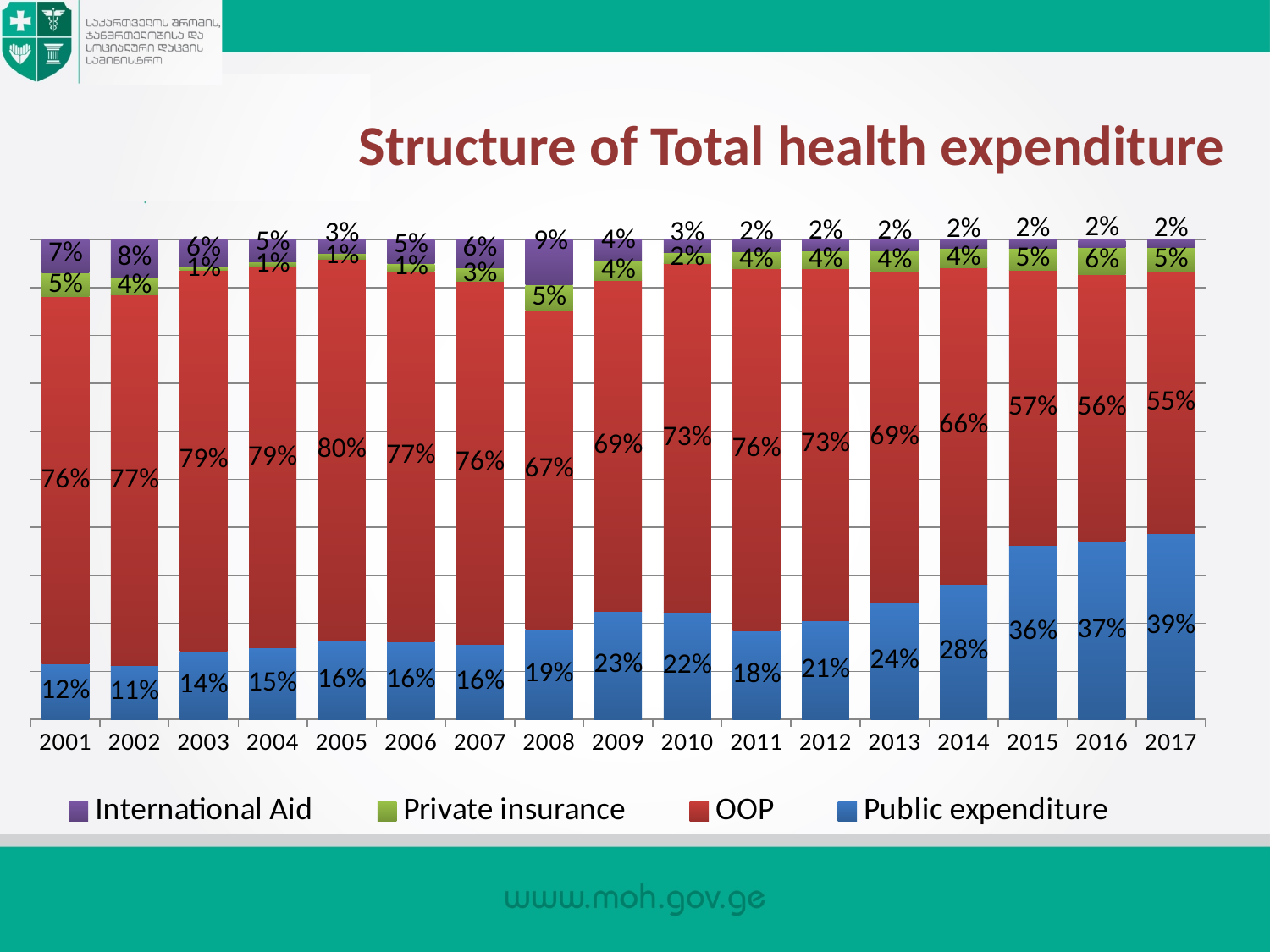
What kind of chart is shown on the slide? Stacked bar chart Does the Public expenditure share generally rise or fall from 2001 to 2017? Rise How many series does the legend list? 4 Which is larger in 2015: the OOP share or the Public expenditure share? OOP How many years are shown on the x axis? 17 What is the International Aid share in 2008? 9% In which year is the OOP share the highest? 2005 What is the Private insurance share in 2016? 6% What is the OOP share of total health expenditure in 2017? 55% What is the Public expenditure share in 2001? 12% By how many percentage points did the Public expenditure share change from 2001 to 2017? 27 percentage points In which year is the Public expenditure share the lowest? 2002